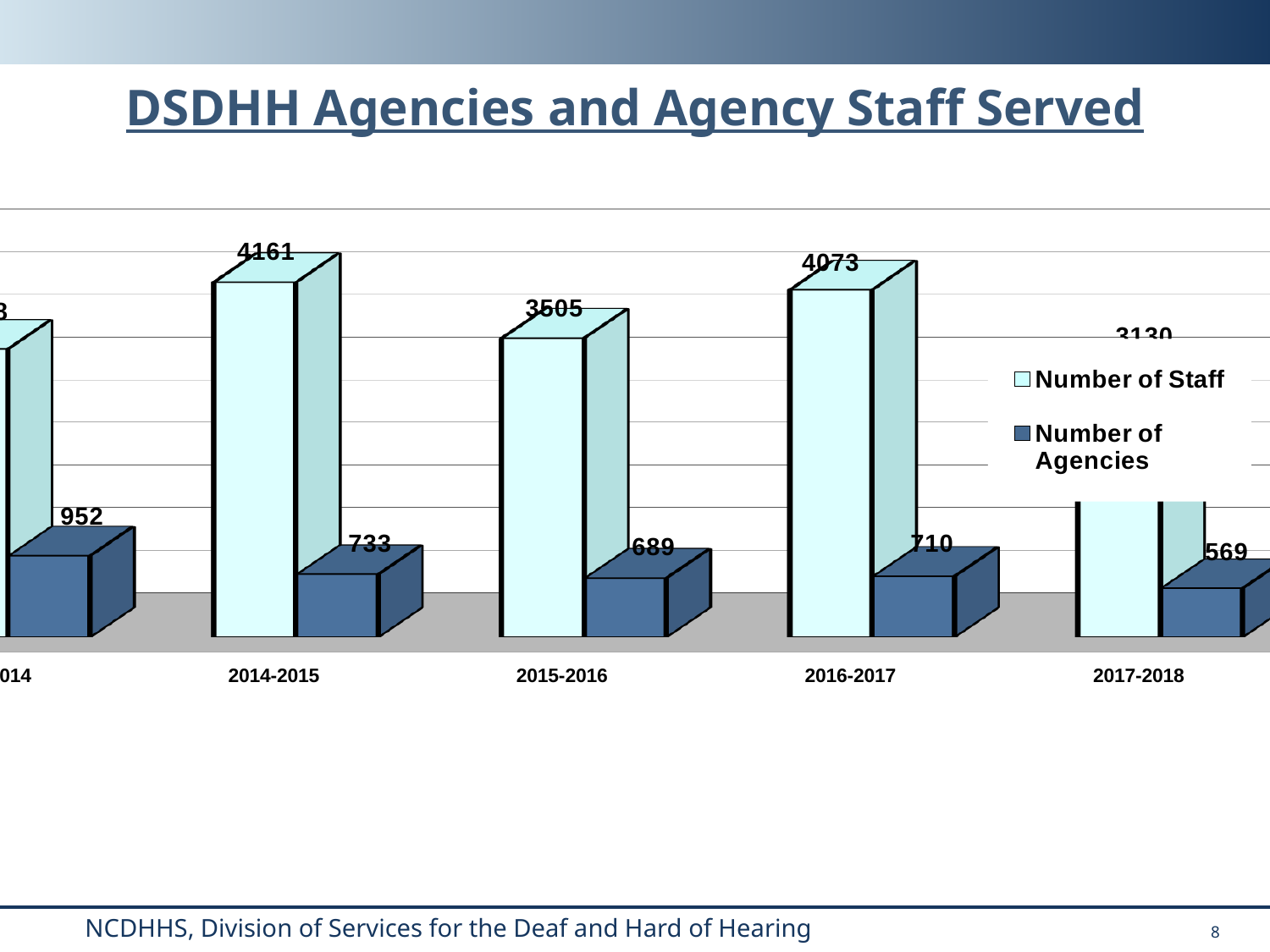
Which year has the higher Number of Staff, 2014-2015 or 2016-2017? 2014-2015 What is the Number of Staff for 2015-2016? 3505 How many series does the legend list? 2 What is the Number of Agencies for 2014-2015? 733 What is the difference between the Number of Agencies in 2016-2017 and in 2015-2016? 21 What is the Number of Agencies for 2017-2018? 569 What is the difference between the Number of Staff in 2014-2015 and in 2015-2016? 656 What is the Number of Agencies for 2015-2016? 689 What is the Number of Staff for 2016-2017? 4073 Which year has the lowest Number of Agencies? 2017-2018 What is the Number of Staff for 2014-2015? 4161 What kind of chart is shown on the slide? bar chart